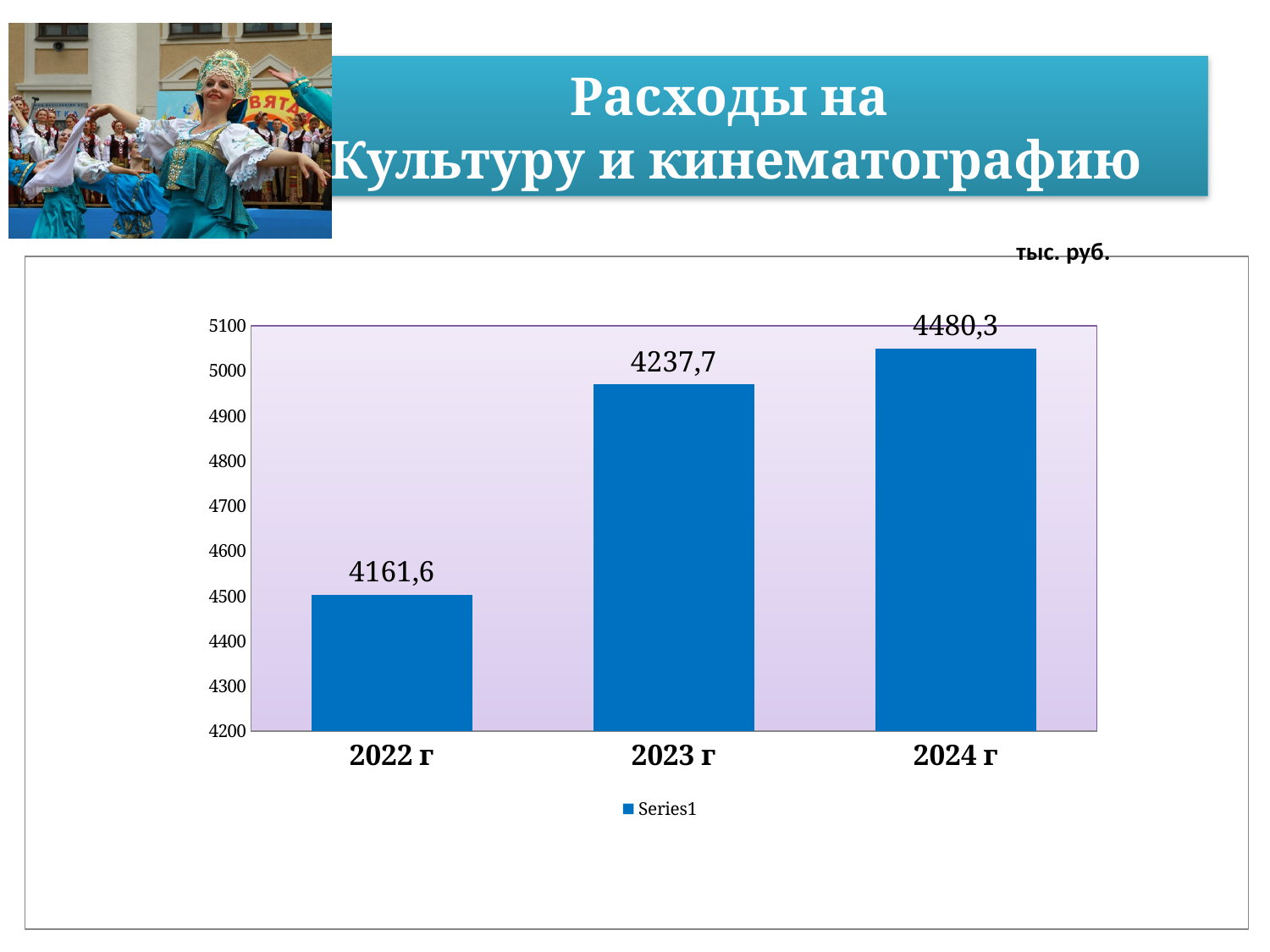
Which year has the lowest value? 2022 г What is the value for 2023 г? 4237,7 How many series does the legend list? 1 What is the difference between the values for 2024 г and 2023 г? 242,6 What is the difference between the values for 2023 г and 2022 г? 76,1 What kind of chart is shown on the slide? bar chart Which is larger, the value for 2022 г or the value for 2024 г? 2024 г Which year has the highest value? 2024 г Do the values rise or fall from 2022 г to 2024 г? rise What is the value for 2022 г? 4161,6 How many categories are shown on the x axis? 3 What is the value for 2024 г? 4480,3